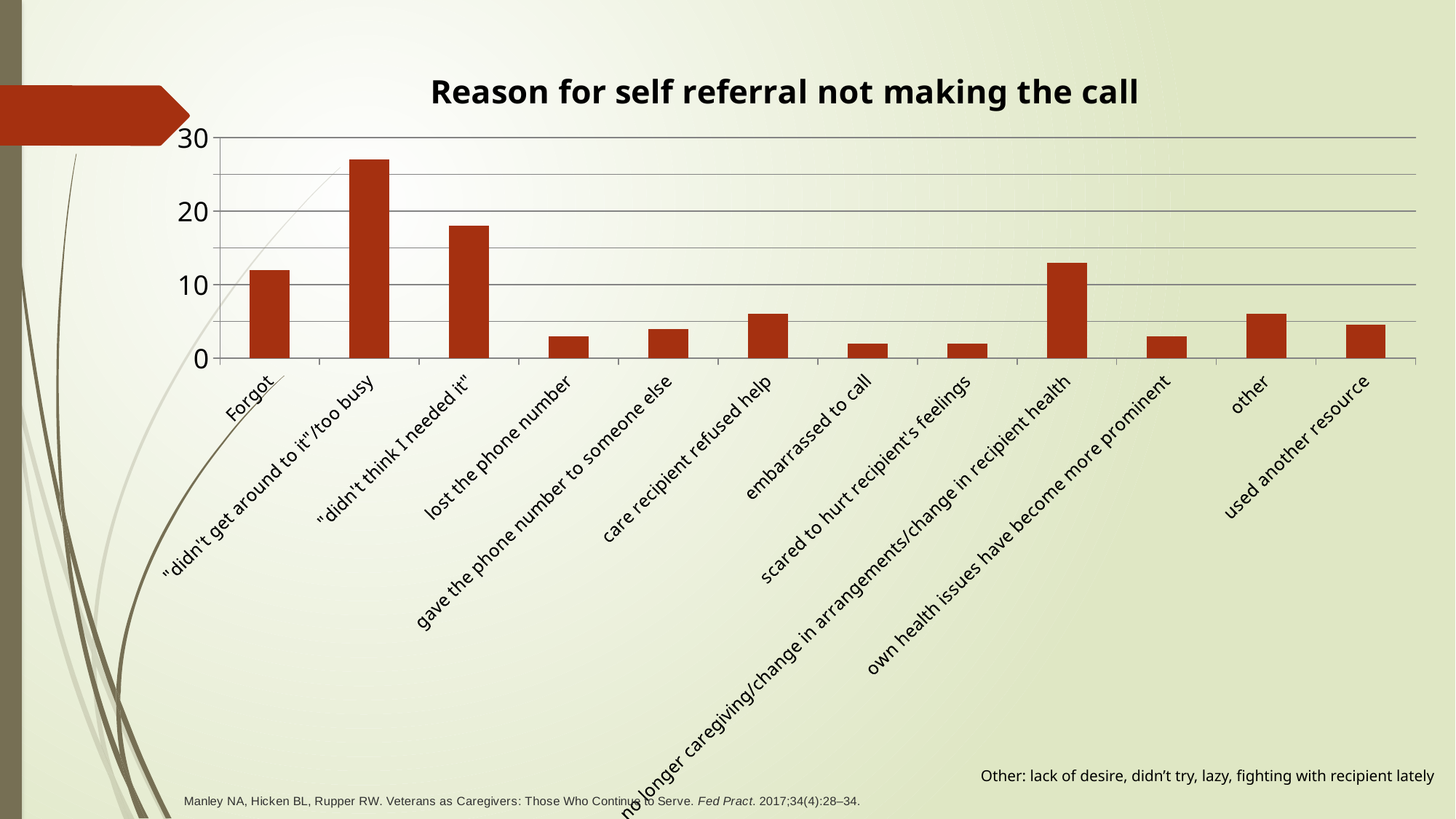
Is the value for "didn't think I needed it" greater or less than 20? less Is the value for "didn't get around to it"/too busy greater or less than 20? greater Is the value for no longer caregiving/change in arrangements/change in recipient health greater or less than 10? greater Which is larger, the value for care recipient refused help or the value for embarrassed to call? care recipient refused help What is the title of the chart? Reason for self referral not making the call Which reason has the highest bar in the chart? "didn't get around to it"/too busy How many categories (reasons) are shown on the x axis of the chart? 12 Which is larger, the value for Forgot or the value for "didn't think I needed it"? "didn't think I needed it" What kind of chart is shown on the slide? bar chart What is the highest value shown on the y axis of the chart? 30